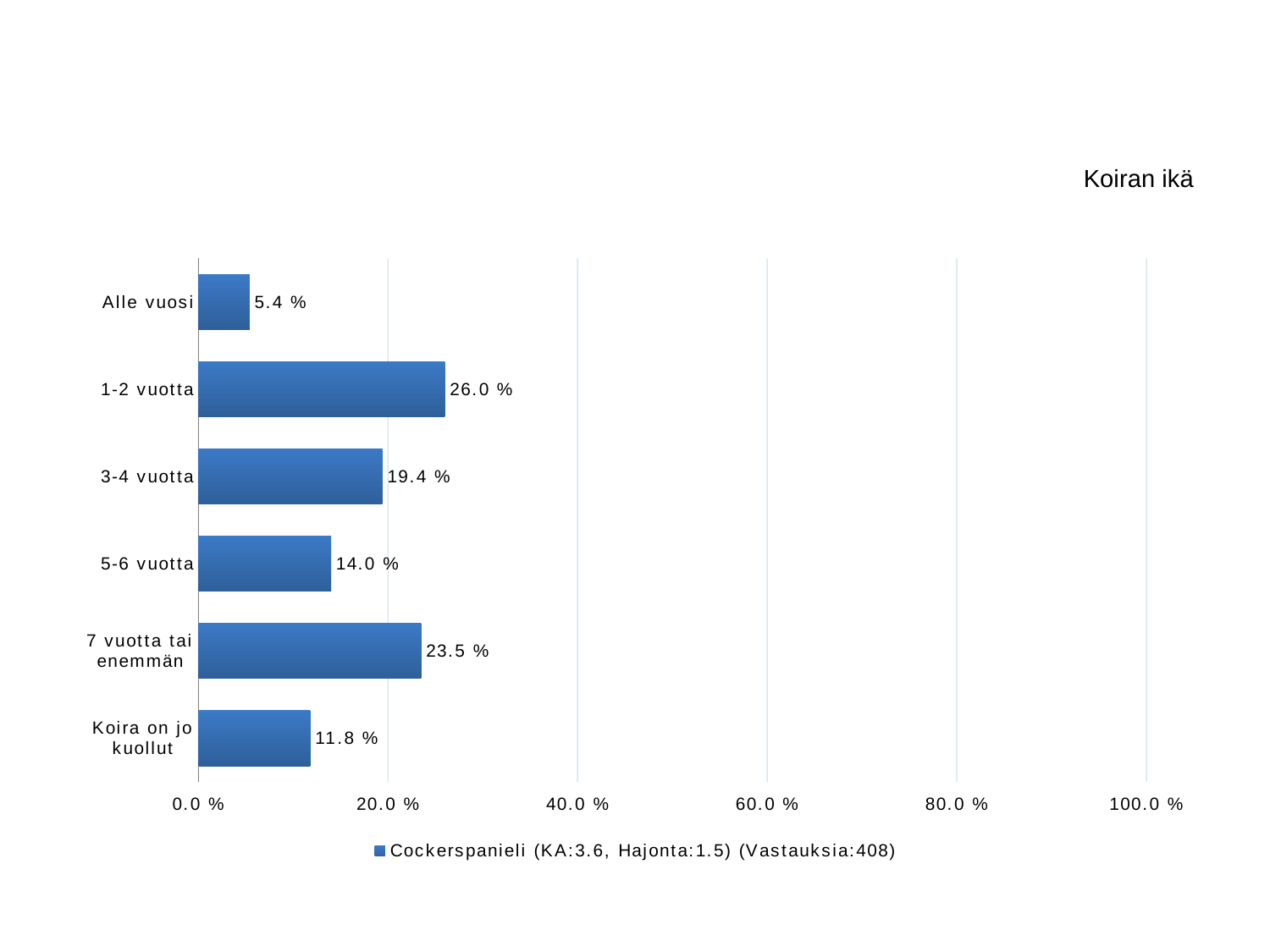
Which category has the highest value? 1-2 vuotta What is the value for "1-2 vuotta"? 26.0 % What is the value for "Koira on jo kuollut"? 11.8 % What is the value for "5-6 vuotta"? 14.0 % How many series does the legend list? 1 Is the value for "7 vuotta tai enemmän" greater or less than 20.0 %? greater What is the difference between the values for "1-2 vuotta" and "3-4 vuotta"? 6.6 % What kind of chart is shown on the slide? bar chart Which category has the lowest value? Alle vuosi How many categories are shown on the chart? 6 What is the title of the chart? Koiran ikä Which is larger, the value for "7 vuotta tai enemmän" or the value for "3-4 vuotta"? 7 vuotta tai enemmän